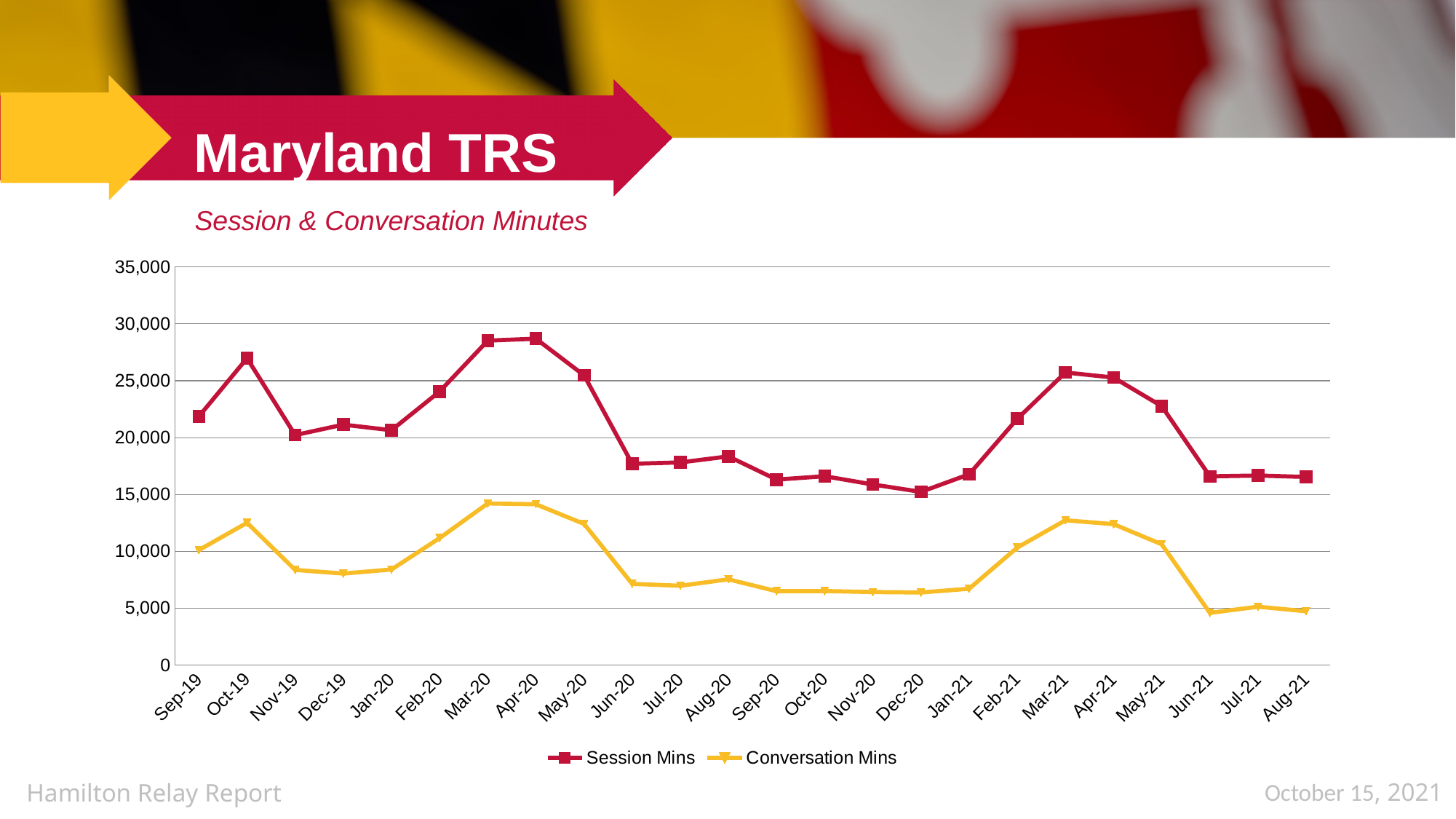
Is the value for Conversation Mins in Oct-19 greater or less than 10,000? greater Is the value for Session Mins in Oct-19 greater or less than 25,000? greater What is the subtitle of the chart shown on the slide? Session & Conversation Minutes Is the value for Session Mins in Jun-20 greater or less than 20,000? less Do the Session Mins values rise or fall from Apr-20 to Jun-20? fall How many series does the legend list? 2 How many months are plotted along the x axis? 24 What kind of chart is shown on the slide? Line chart Which month has the lowest value for Session Mins? Dec-20 Which is larger for Conversation Mins: Jan-21 or Feb-21? Feb-21 Which is larger for Session Mins: Oct-19 or Nov-19? Oct-19